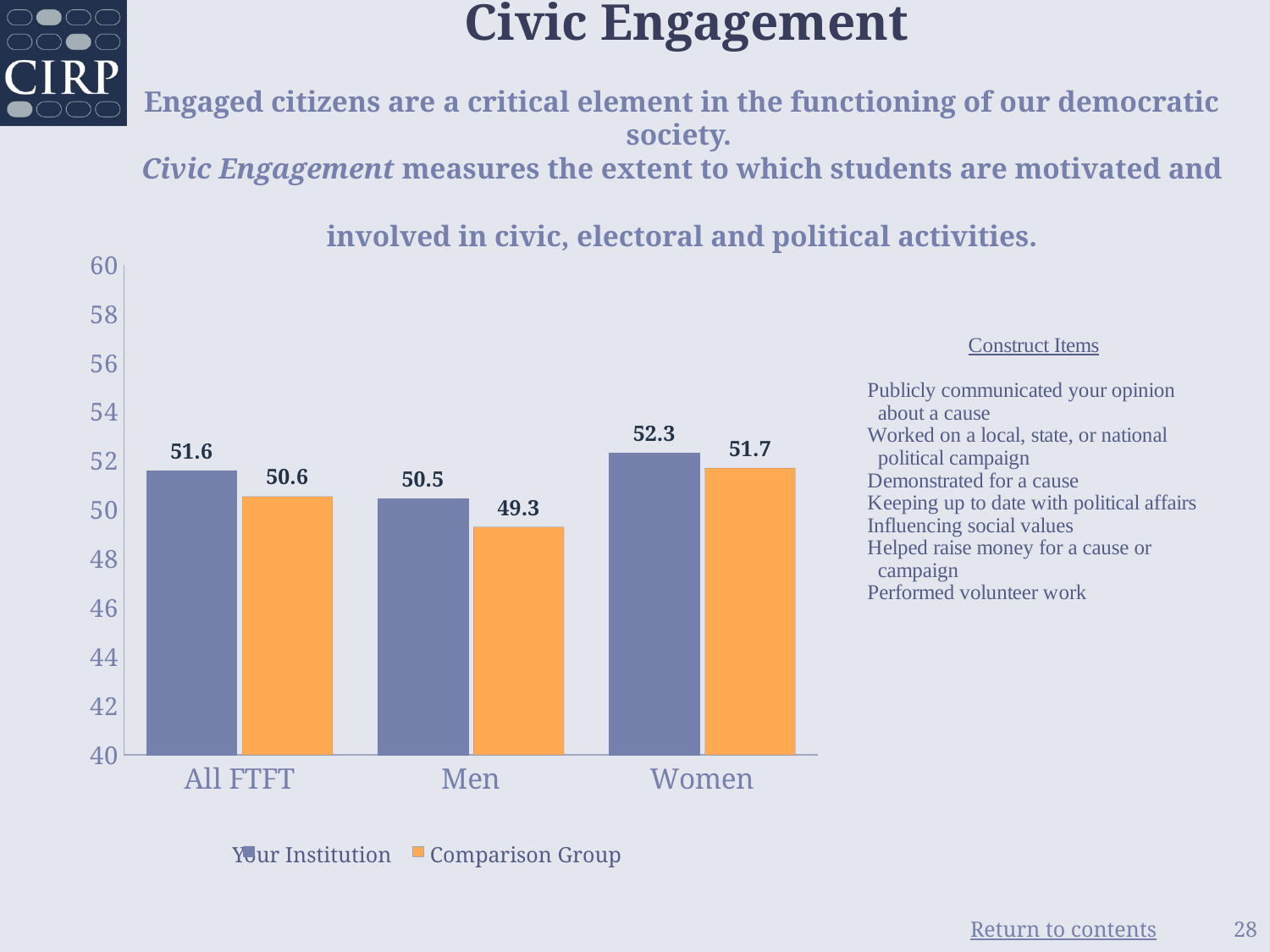
Is the Comparison Group value for Men greater or less than 50? less What is the Comparison Group value for Men? 49.3 How many series does the legend list? 2 Which is larger for All FTFT: Your Institution or Comparison Group? Your Institution What is the Comparison Group value for Women? 51.7 Which category has the highest Your Institution value? Women What kind of chart is shown on the slide? bar chart What is the Your Institution value for Women? 52.3 What is the difference between the Your Institution and Comparison Group values for Men? 1.2 What is the Your Institution value for All FTFT? 51.6 How many categories are shown on the x axis? 3 Which category has the lowest Comparison Group value? Men